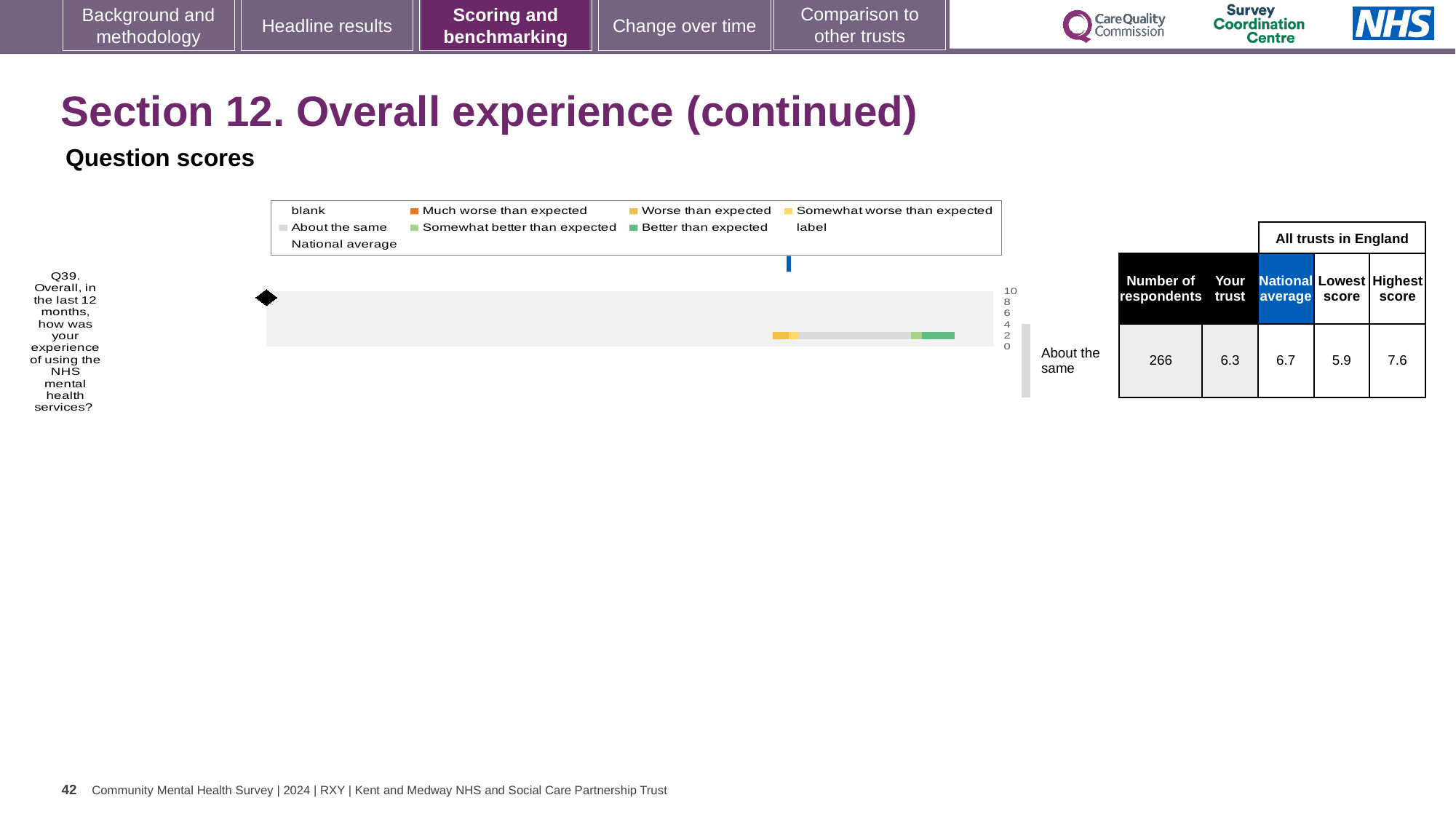
How many questions are plotted on the chart? 1 What is the difference between the National average and the Your trust score for Q39? 0.4 What is the Lowest score among all trusts in England for Q39? 5.9 How many respondents answered Q39? 266 Which benchmark category is the trust's Q39 score placed in? About the same What kind of chart is shown on the slide? bar chart What is the score for Your trust on Q39? 6.3 Which is larger for Q39, the Your trust score or the National average score? National average What is the difference between the Highest score and the Lowest score for Q39? 1.7 What is the National average score for Q39? 6.7 What is the Highest score among all trusts in England for Q39? 7.6 Which legend entry is shown in orange? Much worse than expected